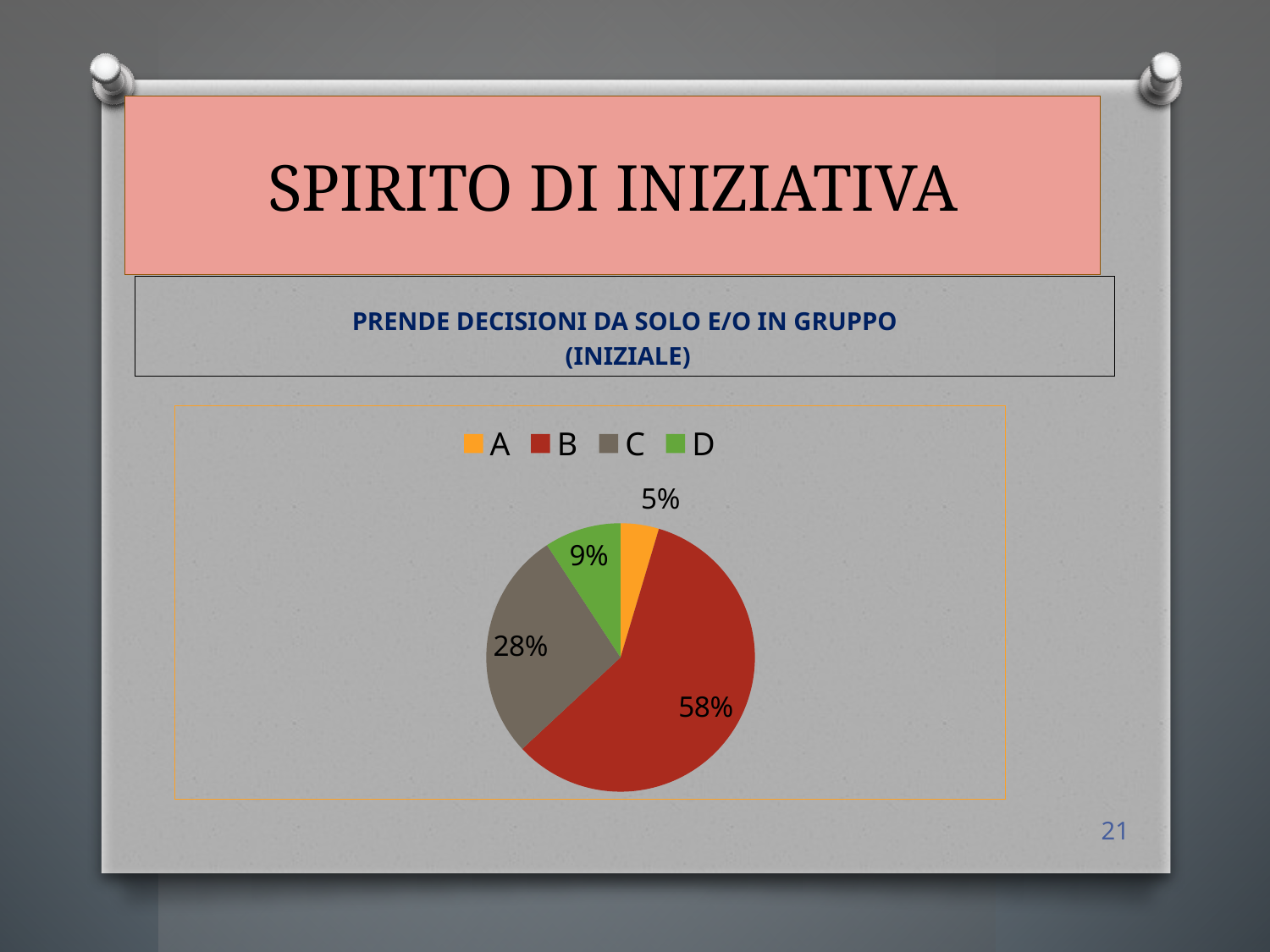
What is the value for category A? 5% What is the difference between the values for B and C? 30% How many categories does the legend list? 4 What colour is the slice for category B? red What is the value for category D? 9% What kind of chart is shown on the slide? pie chart What is the value for category B? 58% Which is larger, the value for C or the value for D? C Which category has the smallest slice? A Which category has the largest slice? B What is the difference between the values for D and A? 4% What is the value for category C? 28%